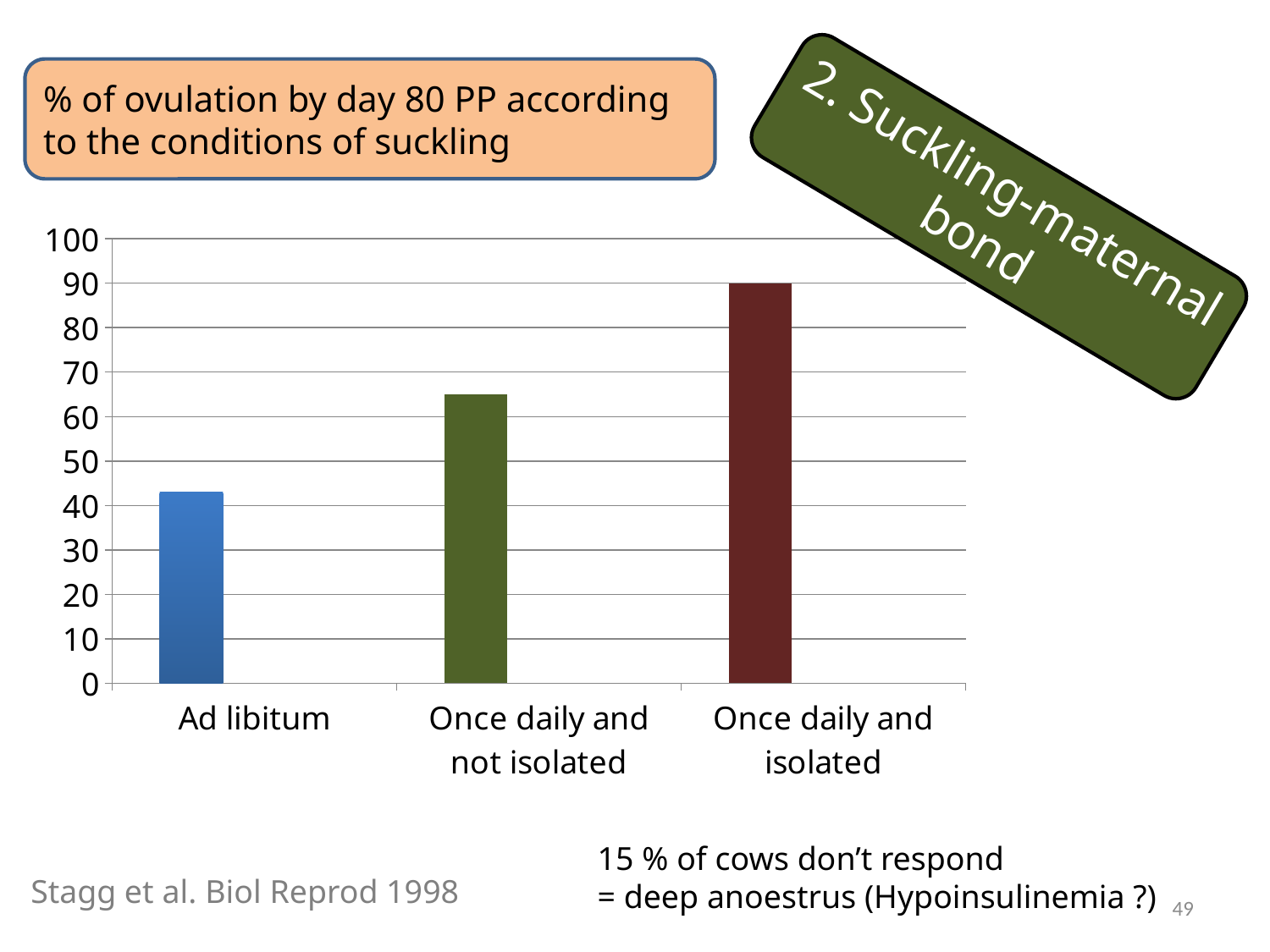
What is the title of the chart in the orange box? % of ovulation by day 80 PP according to the conditions of suckling Do the values rise or fall moving from left to right along the x axis? rise What kind of chart is shown on the slide? bar chart Which suckling condition has the highest % of ovulation by day 80 PP? Once daily and isolated Which is larger: the value for Ad libitum or the value for Once daily and not isolated? Once daily and not isolated Which suckling condition has the lowest % of ovulation by day 80 PP? Ad libitum Is the value for Once daily and not isolated greater or less than 60? greater How many categories are plotted on the x axis of the chart? 3 Is the value for Ad libitum greater or less than 40? greater Is the value for Ad libitum greater or less than 50? less What colour is the bar for Once daily and isolated? dark red